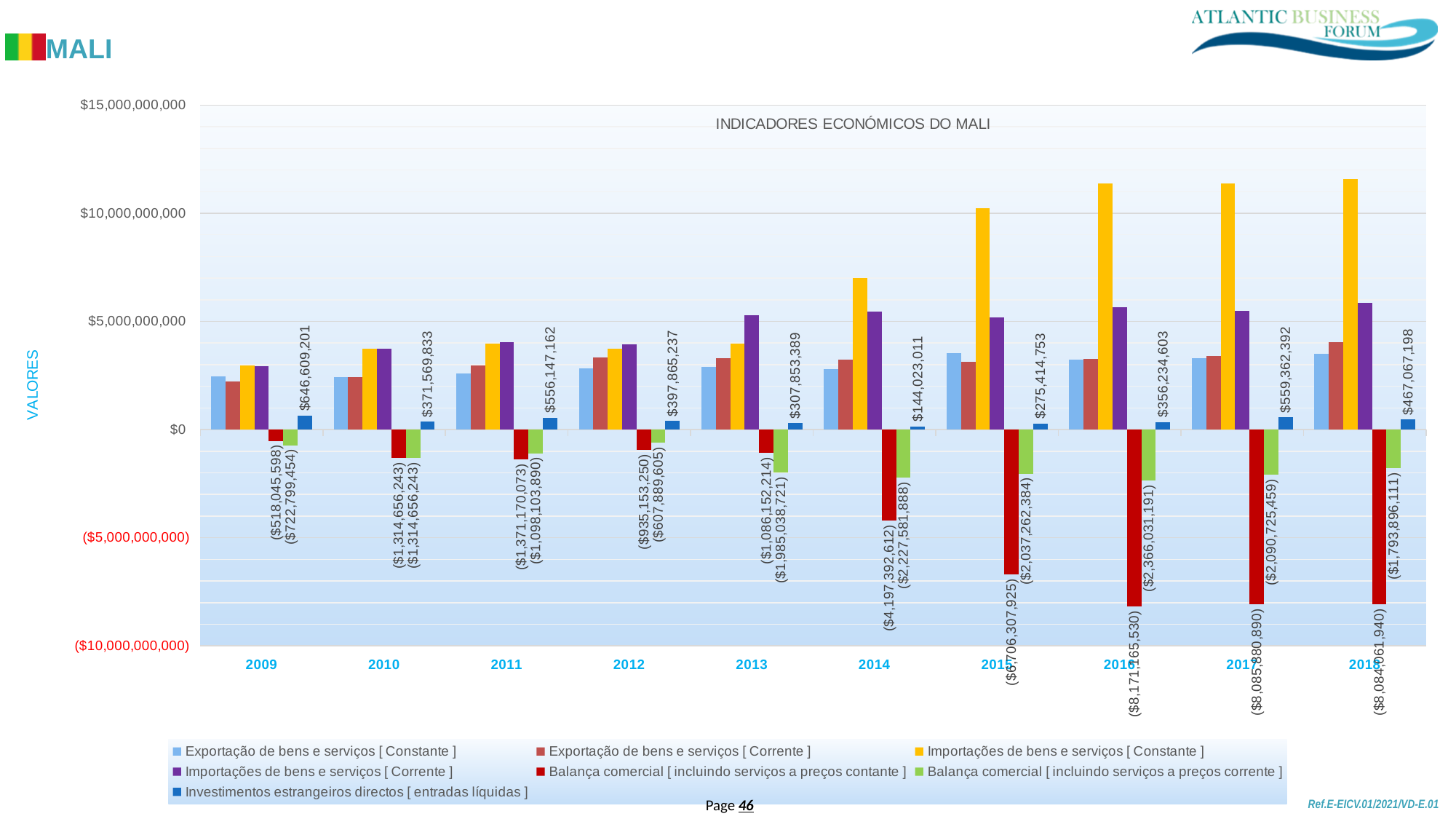
In which year is Investimentos estrangeiros directos [ entradas líquidas ] the highest? 2009 What is the title of the chart? INDICADORES ECONÓMICOS DO MALI Which year has the larger value for Investimentos estrangeiros directos, 2011 or 2012? 2011 In which year is Investimentos estrangeiros directos [ entradas líquidas ] the lowest? 2014 How many series does the legend list? 7 Is the value for Importações de bens e serviços [ Constante ] in 2018 greater or less than $10,000,000,000? greater What is the value of Balança comercial [ incluindo serviços a preços corrente ] in 2013? ($1,985,038,721) How many years are shown on the x axis? 10 What kind of chart is shown on the slide? bar chart What is the difference between Investimentos estrangeiros directos in 2009 and in 2010? $275,039,368 What is the value of Balança comercial [ incluindo serviços a preços contante ] in 2014? ($4,197,392,612) What is the value of Investimentos estrangeiros directos [ entradas líquidas ] in 2009? $646,609,201